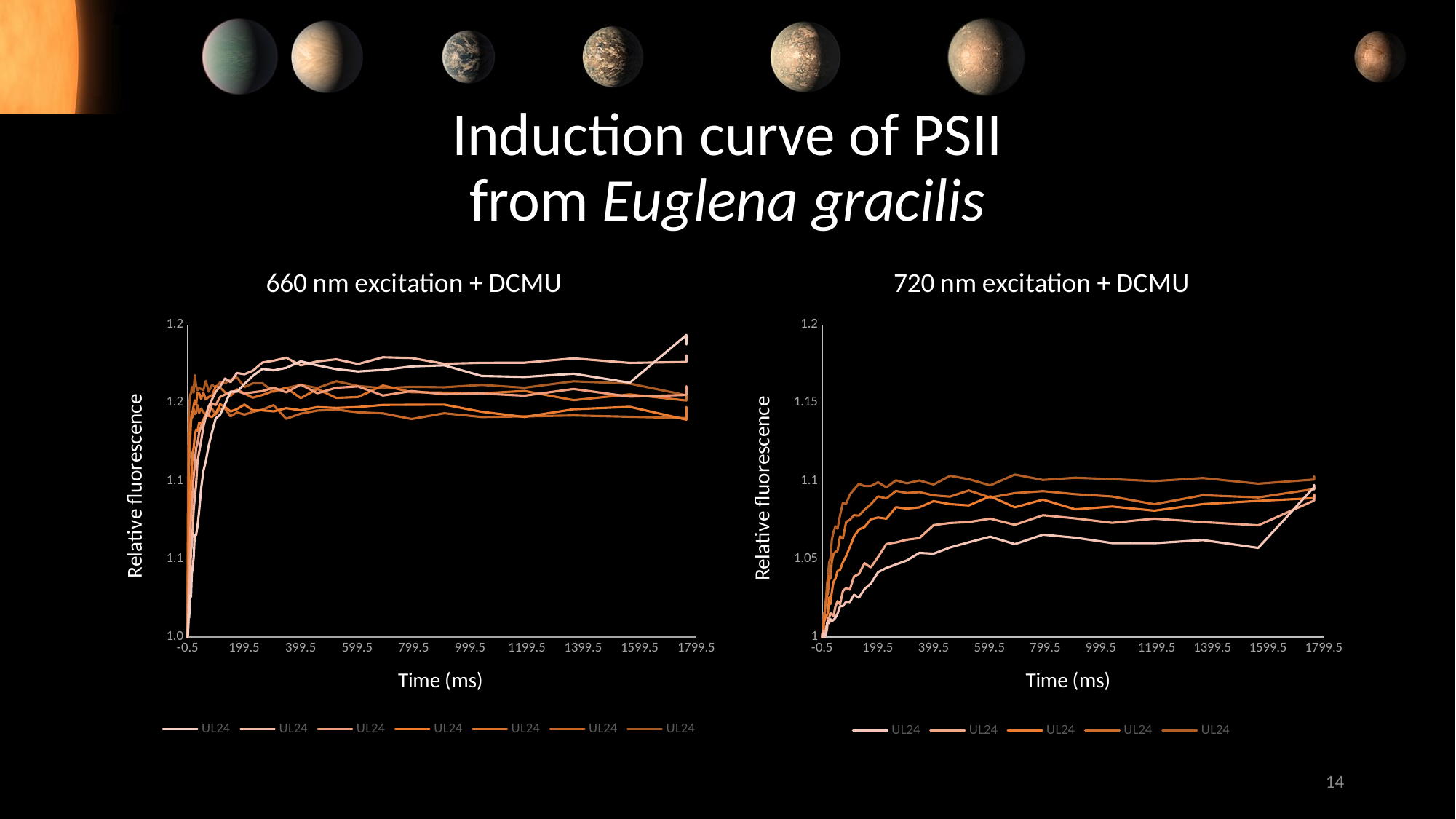
What kind of chart is the '660 nm excitation + DCMU' chart? line chart In the '720 nm excitation + DCMU' chart, are the values of all series at 1799.5 ms greater or less than 1.15? less What is the label shared by every series in the legend of the '720 nm excitation + DCMU' chart? UL24 In the '720 nm excitation + DCMU' chart, are the values of all series at 1799.5 ms greater or less than 1.05? greater What kind of chart is the '720 nm excitation + DCMU' chart? line chart How many series does the legend of the '660 nm excitation + DCMU' chart list? 7 What is the x-axis label of the '720 nm excitation + DCMU' chart? Time (ms) In the '660 nm excitation + DCMU' chart, are the values of all series at 1799.5 ms greater or less than 1.0? greater In the '720 nm excitation + DCMU' chart, do the values rise or fall along the x axis? rise What is the title of the left chart? 660 nm excitation + DCMU How many series does the legend of the '720 nm excitation + DCMU' chart list? 5 In the '660 nm excitation + DCMU' chart, do the values rise or fall from the start of the x axis? rise